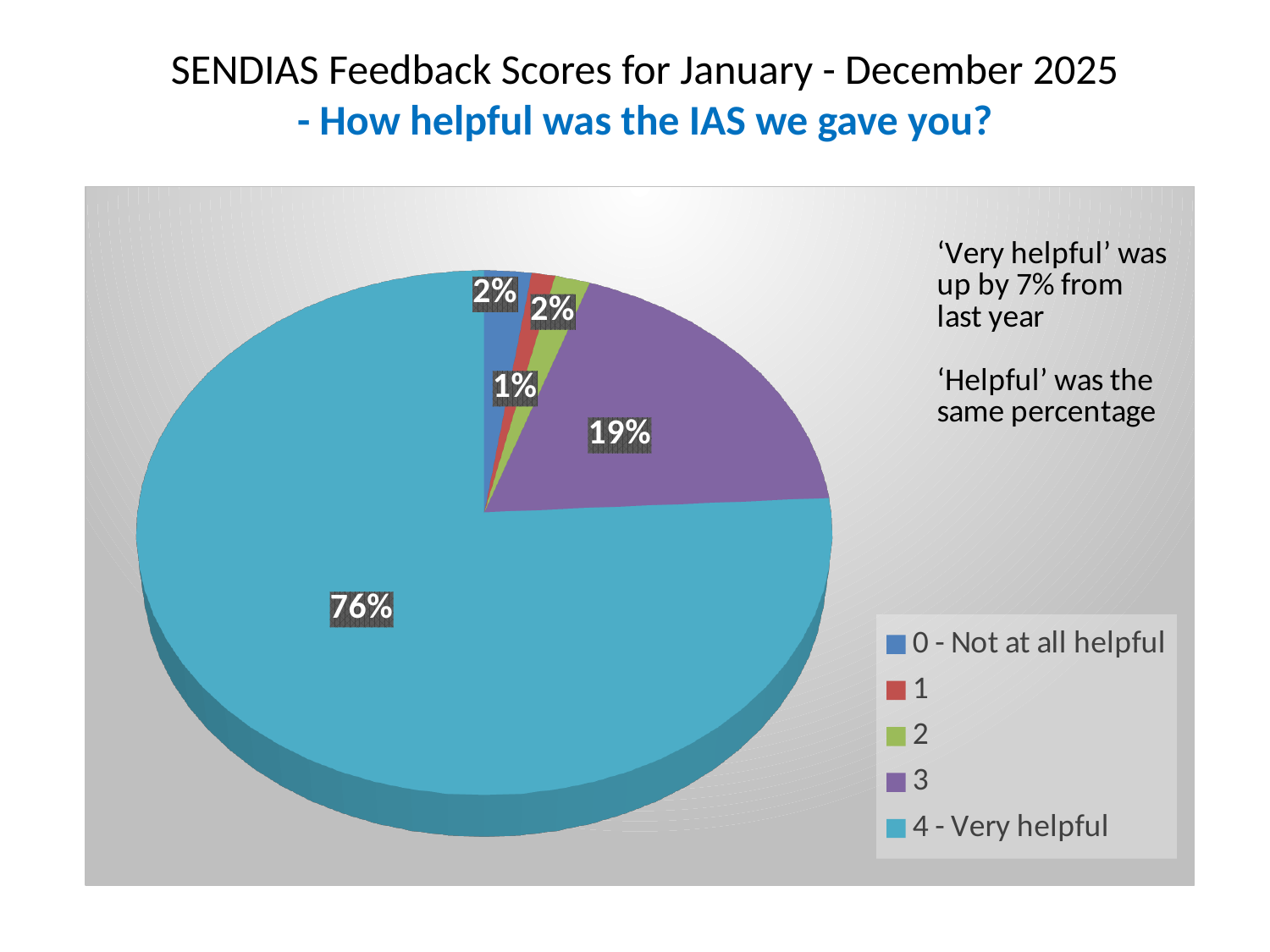
How many categories does the legend list? 5 Which category has the smallest share of the pie? 1 Which is larger, the share for score 3 or the share for '0 - Not at all helpful'? 3 What percentage of responses gave a score of 1? 1% What percentage of responses were '4 - Very helpful'? 76% What is the difference in percentage points between '4 - Very helpful' and the score of 3? 57 What colour is the '4 - Very helpful' slice? teal (light blue) What percentage of responses were '0 - Not at all helpful'? 2% What kind of chart is shown on the slide? pie chart Which category has the largest share of the pie? 4 - Very helpful What is the combined percentage for scores 3 and '4 - Very helpful'? 95% What percentage of responses gave a score of 3? 19%